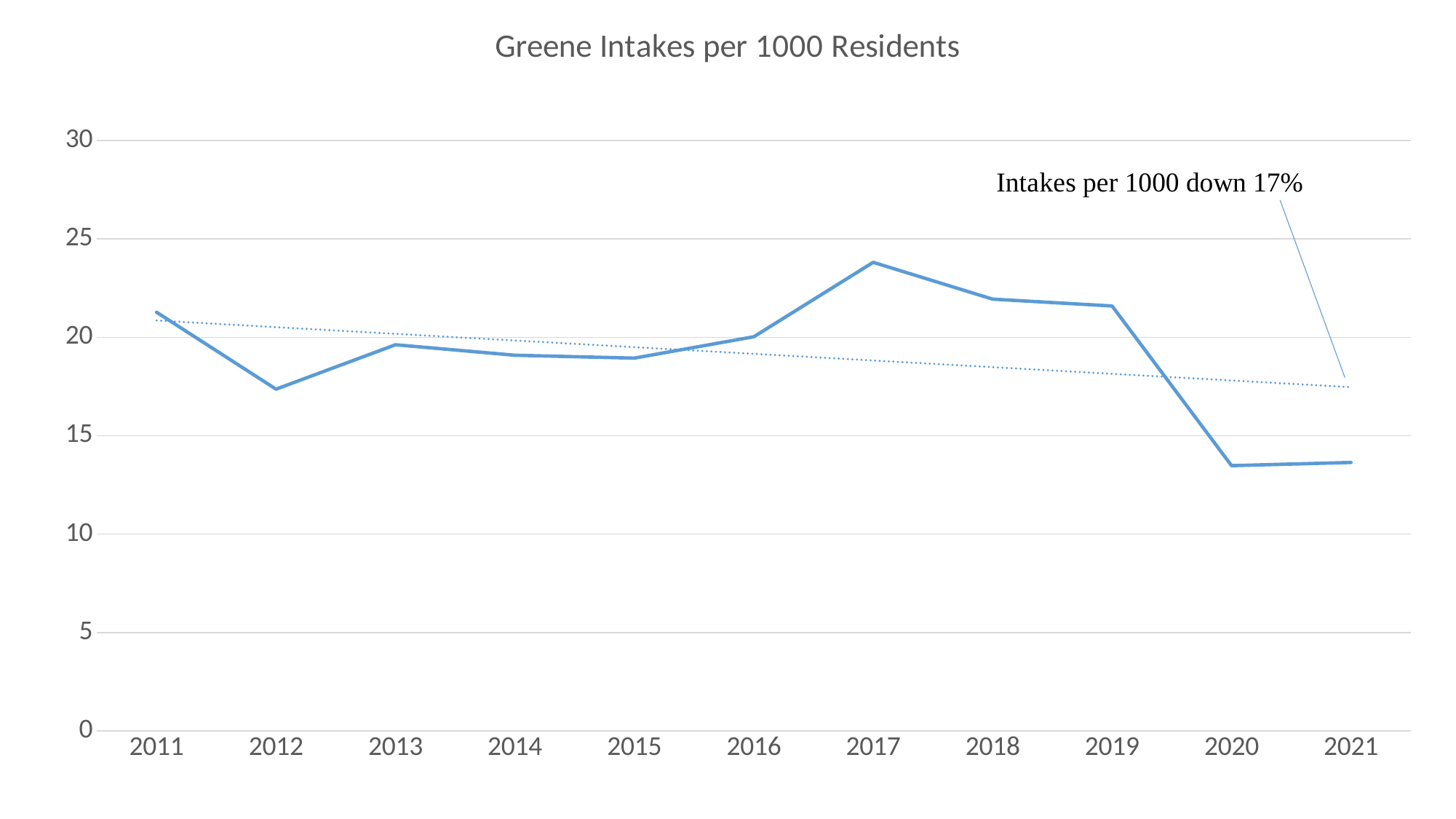
Which year has the larger value, 2019 or 2020? 2019 Is the value for 2012 greater or less than 20? less What does the annotation on the chart say about the change in intakes per 1000? Intakes per 1000 down 17% What is the title of the chart? Greene Intakes per 1000 Residents Which year has the larger value, 2017 or 2012? 2017 Is the value for 2017 greater or less than 20? greater Is the value for 2020 greater or less than 15? less How many years are plotted along the x axis? 11 What kind of chart is shown on the slide? line chart Which year has the highest intakes per 1000 residents? 2017 Overall, do the intakes per 1000 residents rise or fall from 2011 to 2021? fall